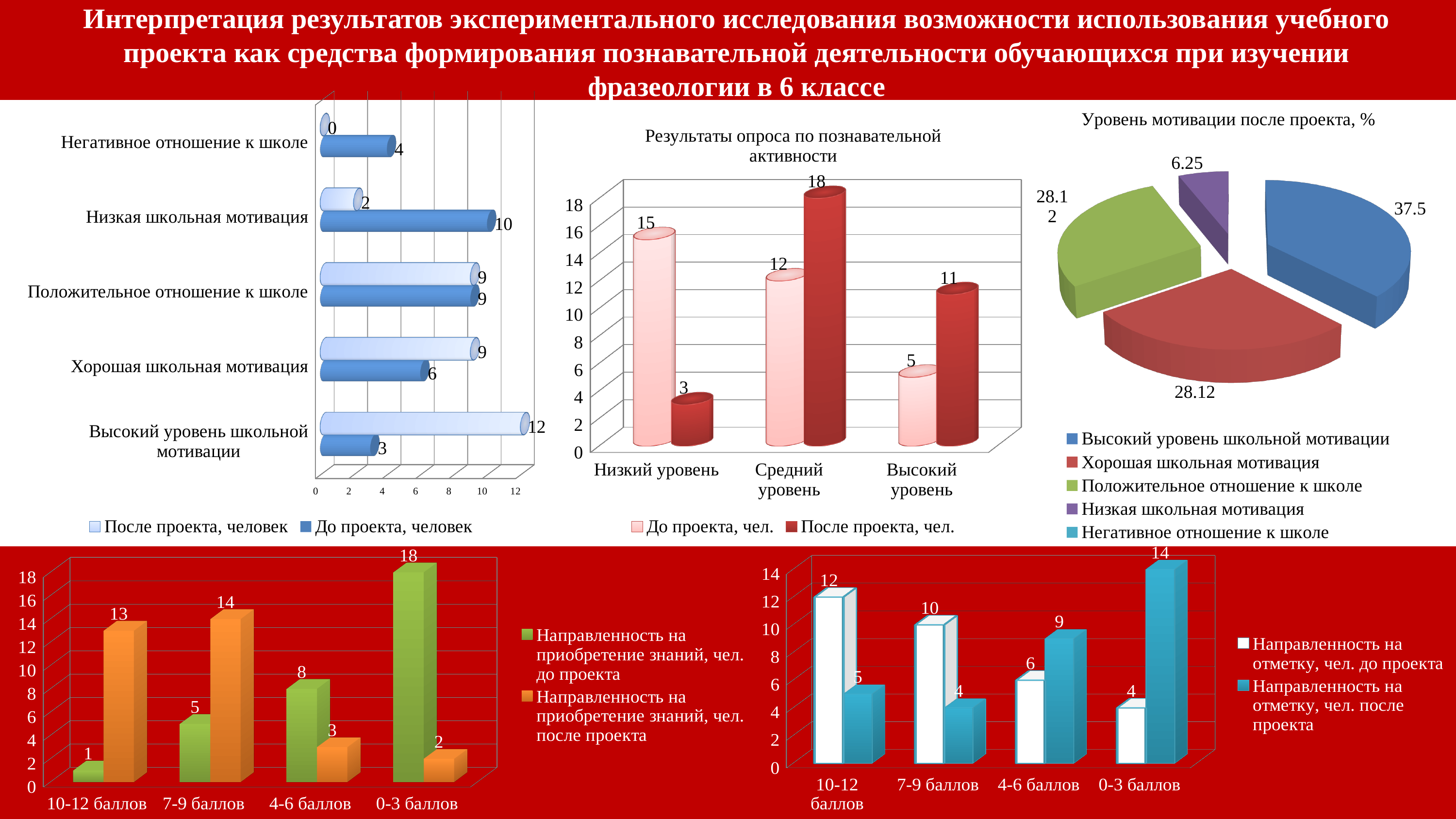
In the top-left bar chart, what is the value for 'Низкая школьная мотивация' in the 'До проекта, человек' series? 10 In the bottom-left bar chart, what is the value for '0-3 баллов' in the 'Направленность на приобретение знаний, чел. до проекта' series? 18 In the chart 'Результаты опроса по познавательной активности', what is the difference between the 'До проекта, чел.' and 'После проекта, чел.' values for 'Низкий уровень'? 12 In the chart 'Результаты опроса по познавательной активности', which category has the highest 'До проекта, чел.' value? Низкий уровень In the bottom-right bar chart, what is the value for '0-3 баллов' in the 'Направленность на отметку, чел. после проекта' series? 14 In the chart 'Результаты опроса по познавательной активности', what is the value for 'Средний уровень' in the 'После проекта, чел.' series? 18 How many entries does the legend of the pie chart 'Уровень мотивации после проекта, %' list? 5 In the top-left bar chart, how many categories are shown on the vertical axis? 5 In the bottom-left bar chart, which is larger for '7-9 баллов': the 'до проекта' value or the 'после проекта' value? после проекта In the pie chart 'Уровень мотивации после проекта, %', what is the share of 'Высокий уровень школьной мотивации'? 37.5 In the top-left bar chart, what is the value for 'Высокий уровень школьной мотивации' in the 'После проекта, человек' series? 12 What type of chart is 'Уровень мотивации после проекта, %'? Pie chart